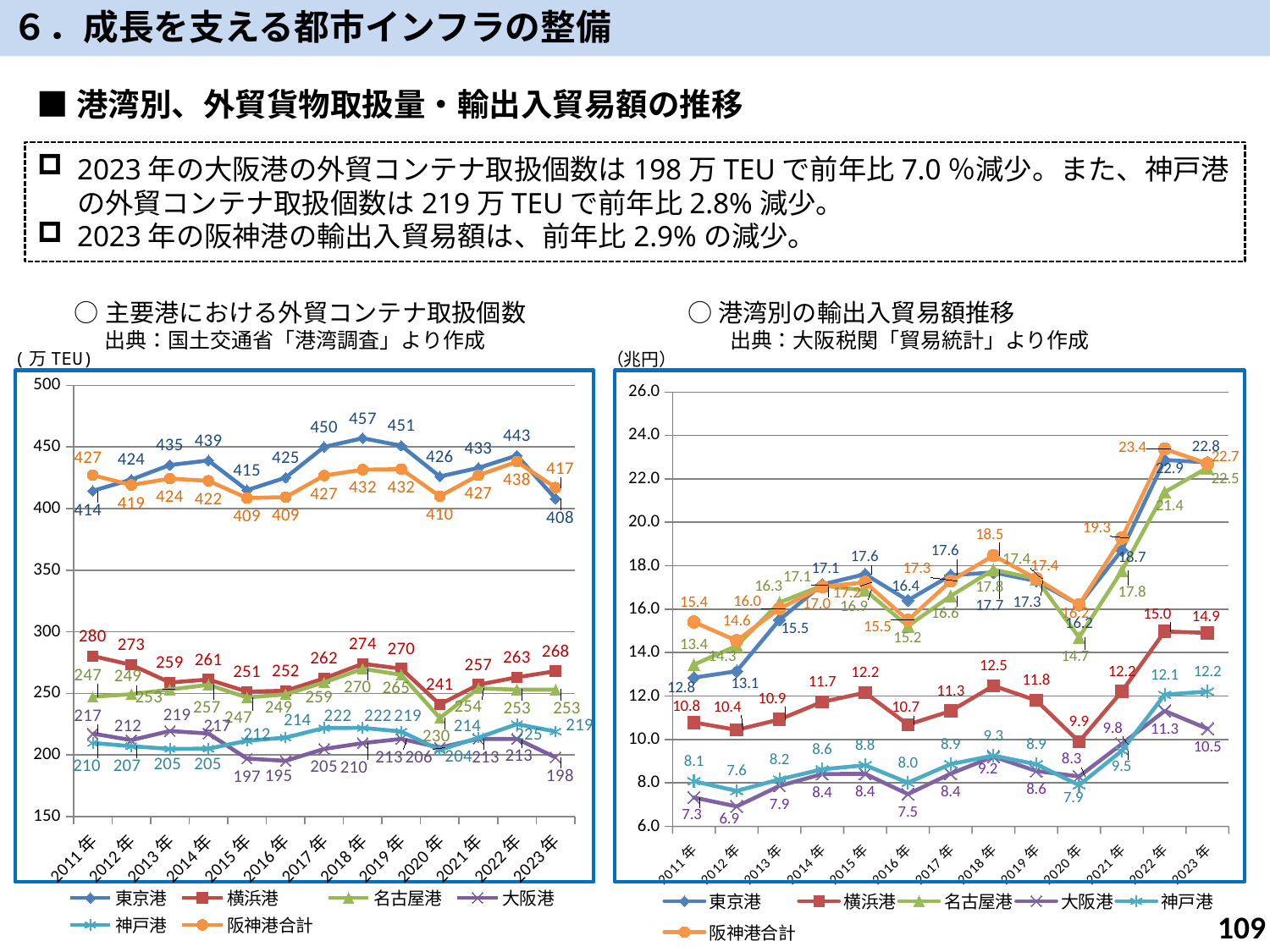
In the left chart (主要港における外貿コンテナ取扱個数), what is the difference between 東京港 and 横浜港 in 2011年? 134 In the right chart (港湾別の輸出入貿易額推移), which series has the lowest value in 2012年? 大阪港 In the left chart (主要港における外貿コンテナ取扱個数), what is the value for 東京港 in 2018年? 457 In the left chart (主要港における外貿コンテナ取扱個数), what is the value for 横浜港 in 2020年? 241 In the left chart (主要港における外貿コンテナ取扱個数), how many series does the legend list? 6 In the right chart (港湾別の輸出入貿易額推移), which is larger in 2023年, 東京港 or 名古屋港? 東京港 What kind of chart is the right chart (港湾別の輸出入貿易額推移)? Line chart In the right chart (港湾別の輸出入貿易額推移), what is the difference between 横浜港 in 2022年 and 2021年? 2.8 In the right chart (港湾別の輸出入貿易額推移), what is the value for 阪神港合計 in 2022年? 23.4 In the right chart (港湾別の輸出入貿易額推移), what is the value for 横浜港 in 2020年? 9.9 In the left chart (主要港における外貿コンテナ取扱個数), in which year does 東京港 reach its highest value? 2018年 In the left chart (主要港における外貿コンテナ取扱個数), what is the value for 阪神港合計 in 2023年? 417